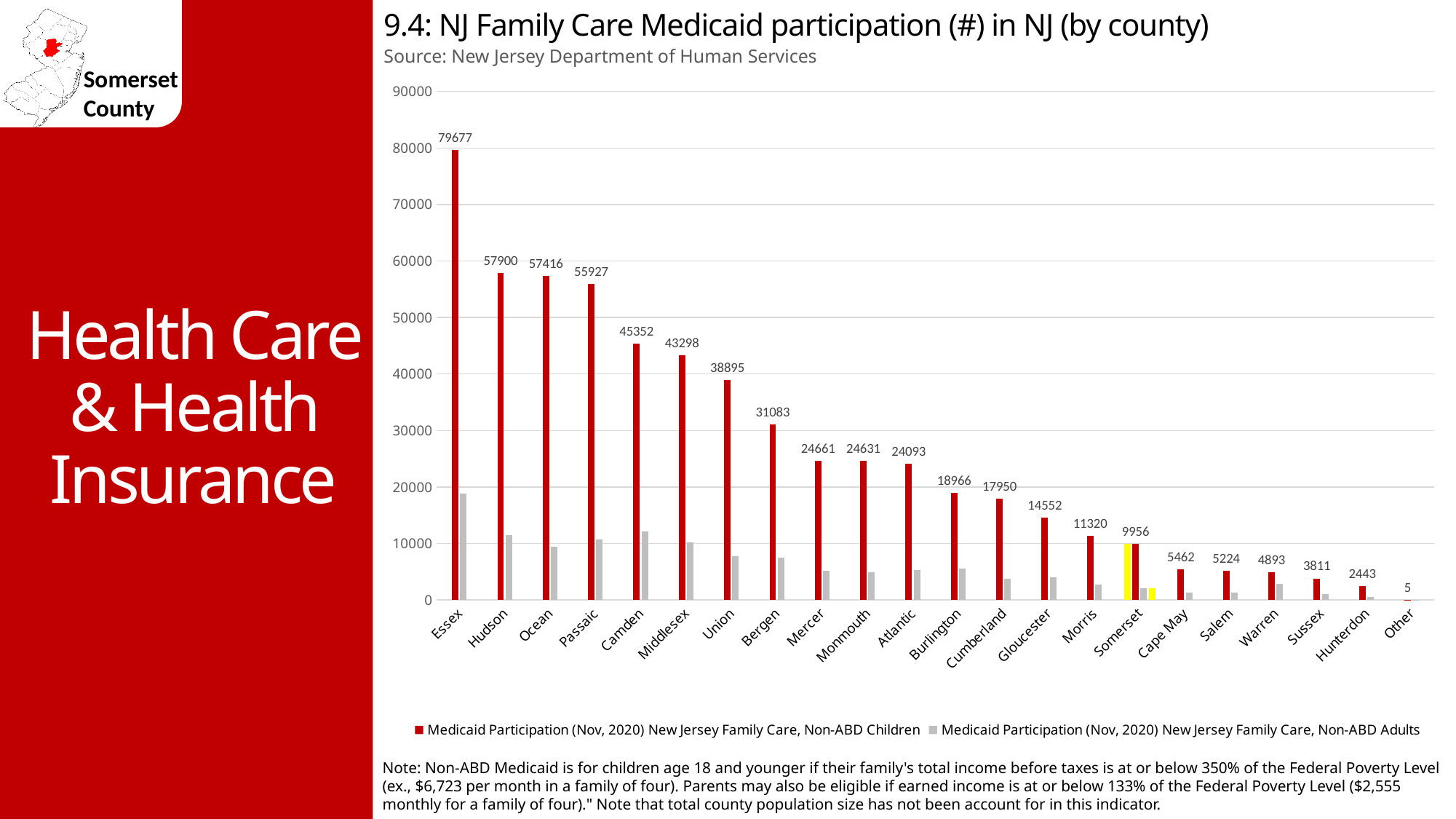
Which county has a larger Non-ABD Children value, Camden or Middlesex? Camden How many categories are shown on the x axis of the chart? 22 Which category has the lowest Non-ABD Children Medicaid participation? Other Is the Non-ABD Adults value for Essex greater or less than 10000? greater What is the Non-ABD Children Medicaid participation value for Hunterdon? 2443 What is the Non-ABD Children Medicaid participation value for Somerset? 9956 What is the difference between the Non-ABD Children values for Essex and Hudson? 21777 How many series does the legend list? 2 Which county has the highest Non-ABD Children Medicaid participation? Essex Is the Non-ABD Adults value for Somerset greater or less than 10000? less What is the Non-ABD Children Medicaid participation value for Essex? 79677 What is the difference between the Non-ABD Children values for Somerset and Cape May? 4494